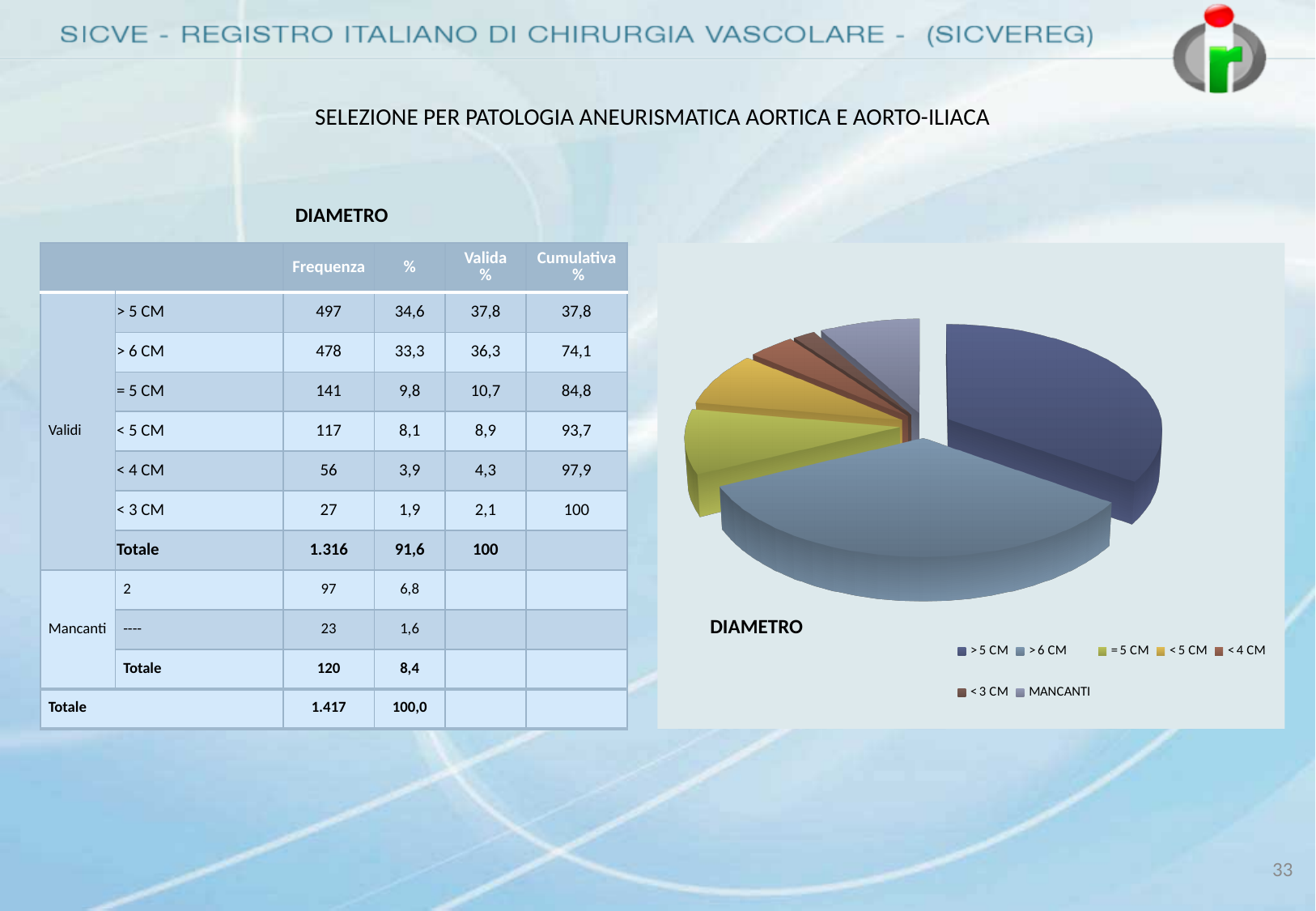
According to the table on the slide, what is the difference in frequency between the > 5 CM and > 6 CM categories plotted in the pie chart? 19 Which category has the smallest slice in the pie chart? < 3 CM Which slice of the pie chart is larger: > 6 CM or MANCANTI? > 6 CM What is the title of the pie chart? DIAMETRO Which category in the pie chart is represented by the dark blue slice? > 5 CM How many categories does the pie chart's legend list? 7 What kind of chart is shown on the slide? pie chart Which slice of the pie chart is larger: > 5 CM or = 5 CM? > 5 CM Which slice of the pie chart is larger: = 5 CM or < 3 CM? = 5 CM According to the table on the slide, what is the frequency for the > 5 CM category plotted in the pie chart? 497 According to the table on the slide, what is the frequency for the < 3 CM category plotted in the pie chart? 27 According to the table on the slide, what is the frequency for the MANCANTI category plotted in the pie chart? 120